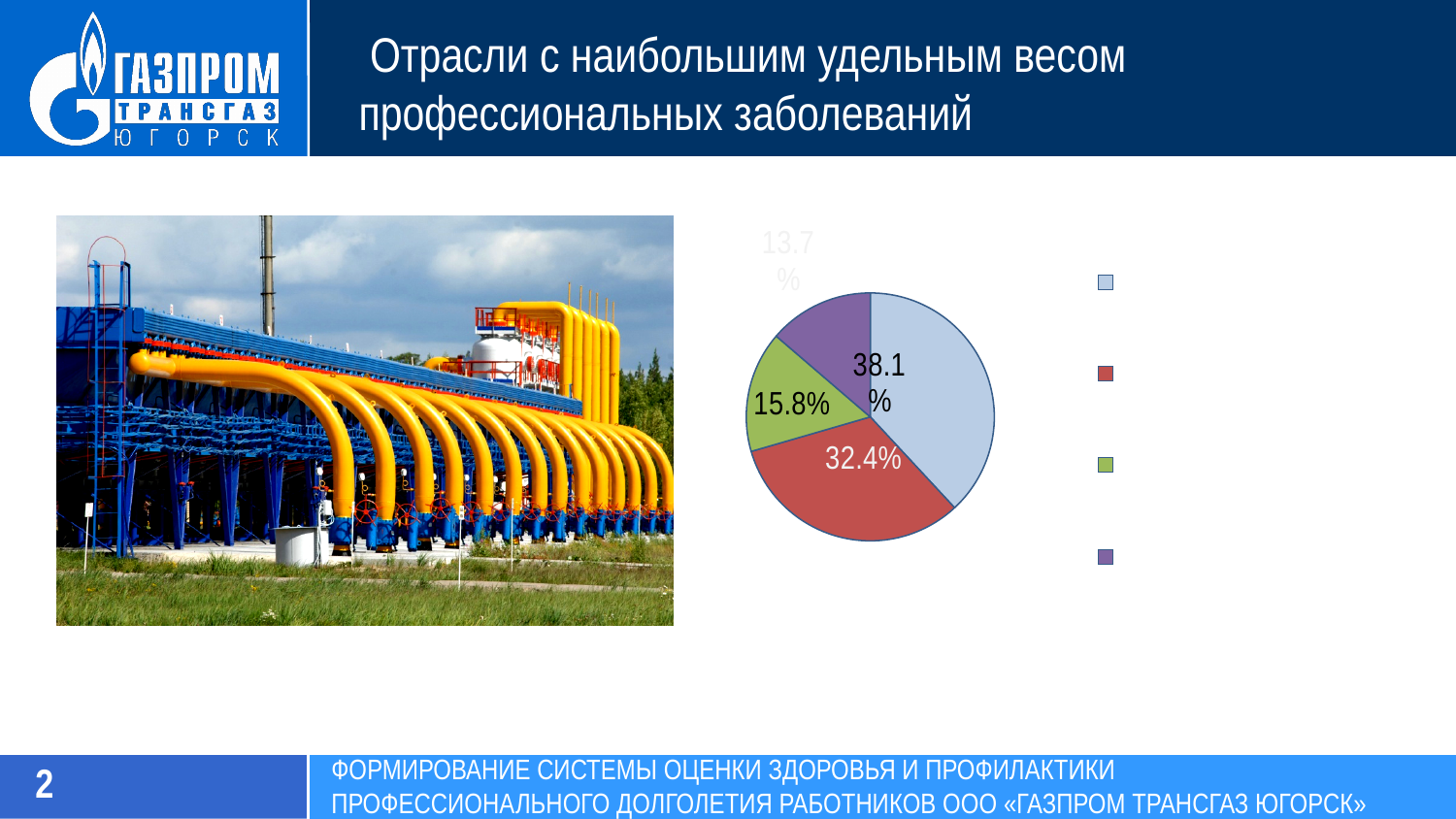
What value is shown for the green slice of the pie chart? 15.8% How many entries does the legend of the pie chart list? 4 What is the difference between the light blue slice (38.1%) and the red slice (32.4%) in the pie chart? 5.7 percentage points What is the title of the slide containing the pie chart? Отрасли с наибольшим удельным весом профессиональных заболеваний What value is shown for the red slice of the pie chart? 32.4% What is the value of the largest slice in the pie chart? 38.1% How many slices does the pie chart have? 4 What value is shown for the light blue slice of the pie chart? 38.1% What kind of chart is shown on the slide? pie chart Which slice is larger in the pie chart, the red one or the green one? the red one What is the difference between the red slice (32.4%) and the green slice (15.8%) in the pie chart? 16.6 percentage points What is the value of the smallest slice in the pie chart? 13.7%